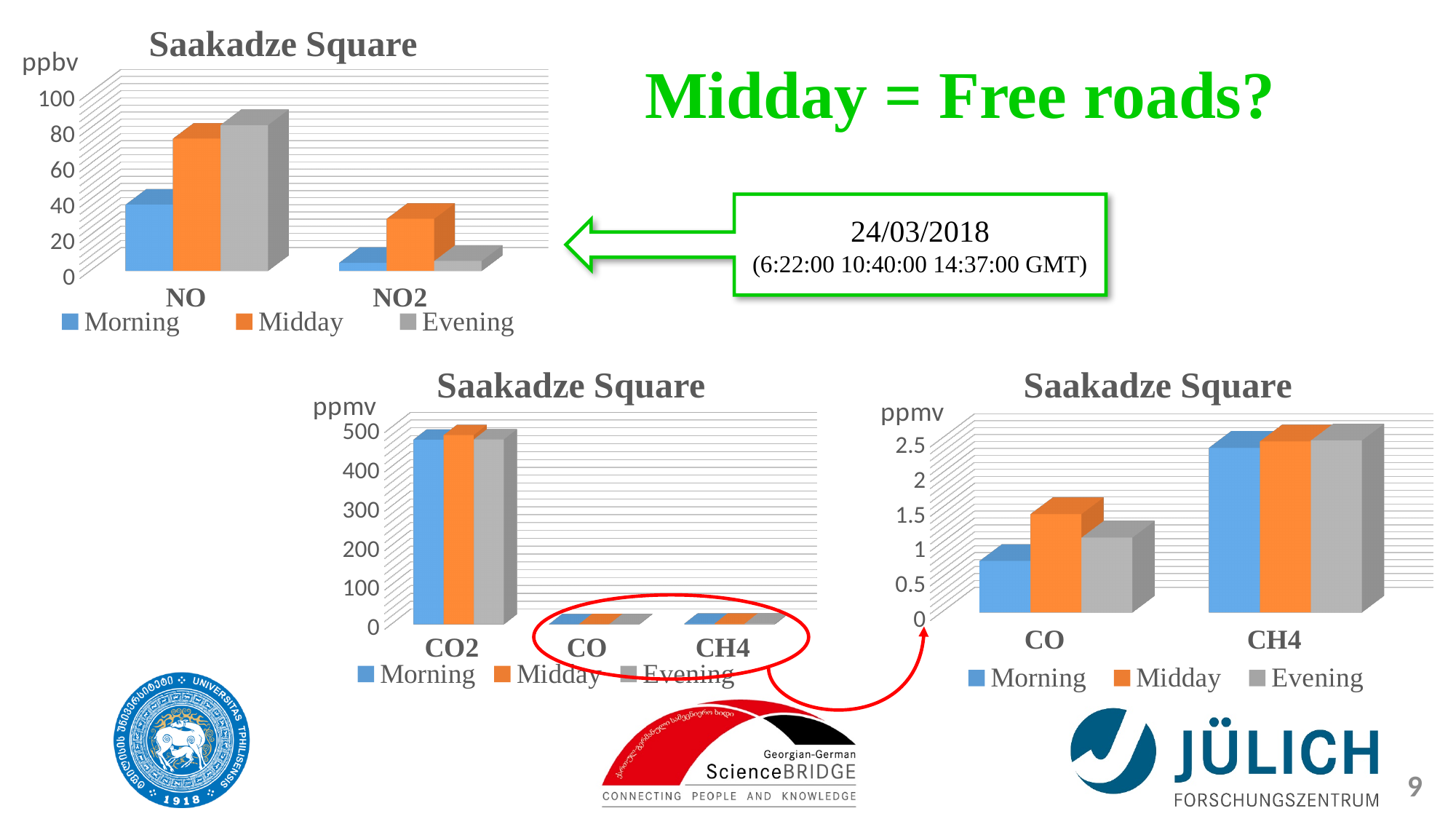
In the bottom-middle chart, is the Morning value for CO2 greater or less than 400? greater In the bottom-right chart, is the Morning value for CH4 greater or less than 2? greater In the top-left chart, is the Midday value for NO greater or less than 60? greater In the top-left chart, how many series does the legend list? 3 In the bottom-middle chart, which category has the highest values? CO2 In the top-left chart, what kind of chart is shown? bar chart In the bottom-right chart, which series has the highest value for CO? Midday In the bottom-middle chart, how many categories are shown on the x axis? 3 In the top-left chart, which series has the highest value for NO2? Midday In the top-left chart, which is larger: the Midday value for NO or the Midday value for NO2? Midday value for NO In the top-left chart, what unit is shown on the vertical axis? ppbv